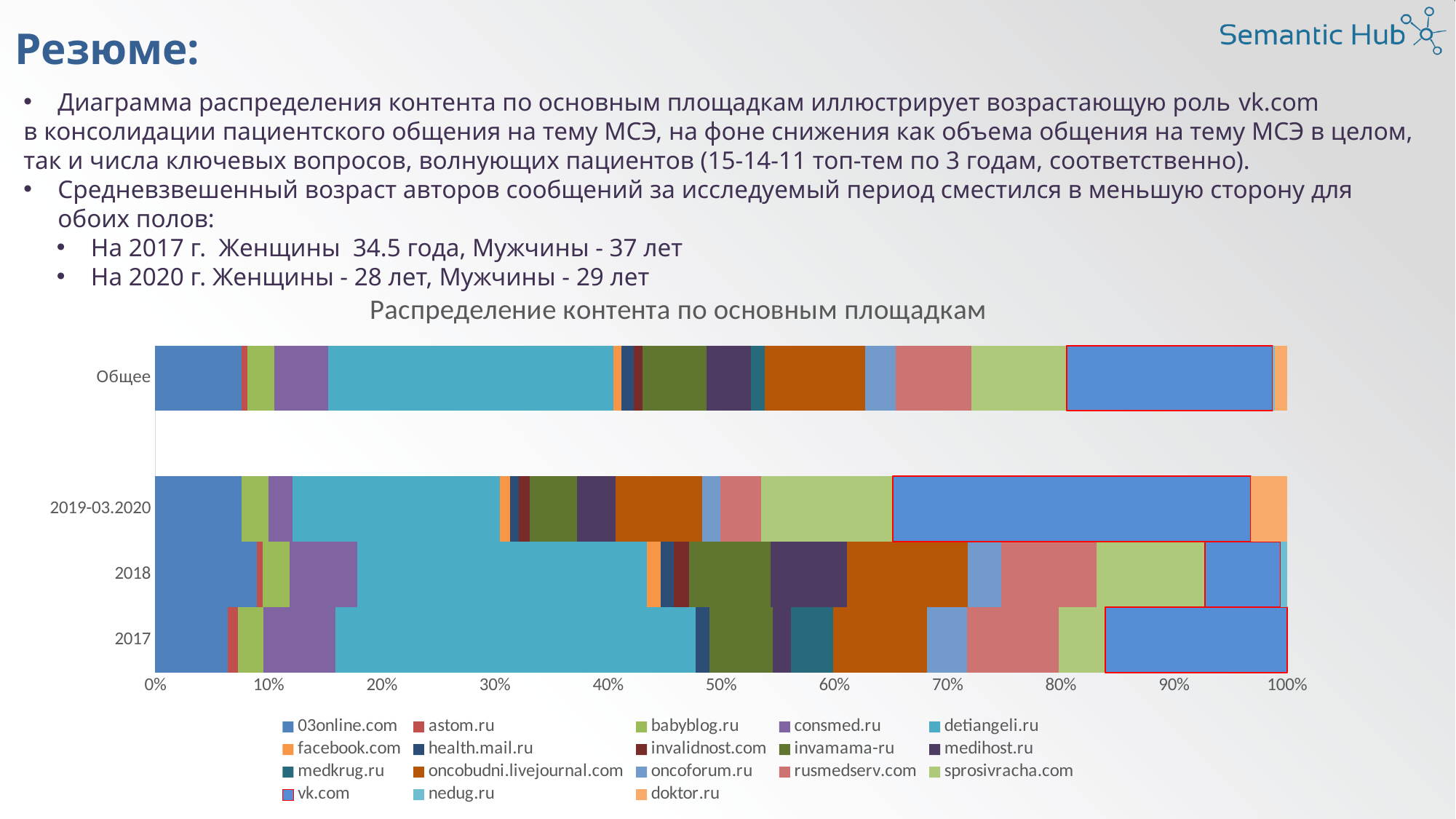
How many categories (bars) does the chart show? 4 Is the share of vk.com in the 2019-03.2020 bar greater or less than 20%? greater Is the share of 03online.com in the 2017 bar greater or less than 10%? less In which year bar does vk.com have the smallest share? 2018 What is the title of the chart? Распределение контента по основным площадкам Which series has the largest segment in the Общее bar? detiangeli.ru Which series is highlighted with a red outline in the chart? vk.com What kind of chart is shown on the slide? Stacked bar chart In which year bar does vk.com have the largest share? 2019-03.2020 How many series does the legend list? 18 Is the share of vk.com in 2019-03.2020 larger or smaller than in 2018? larger